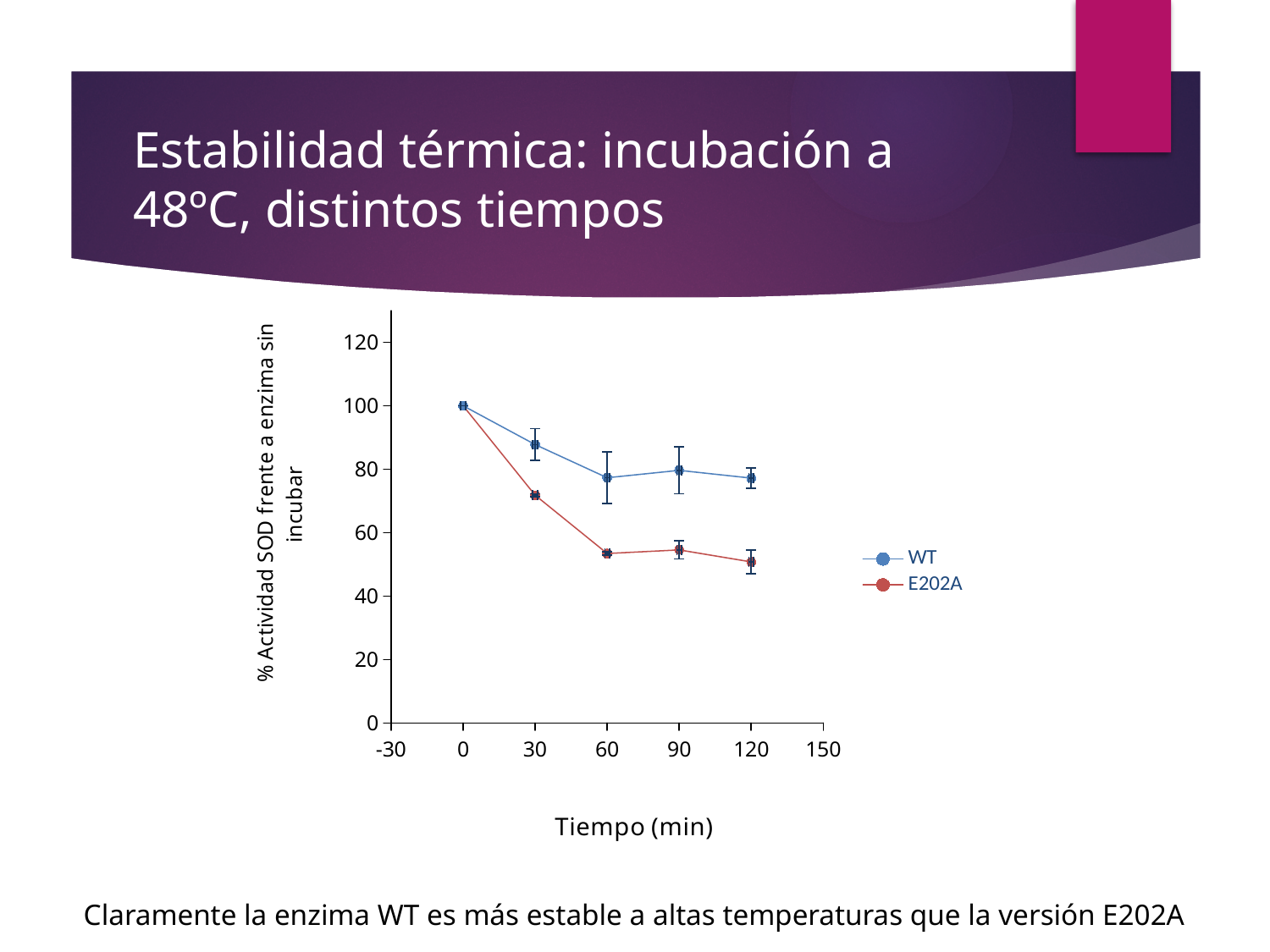
What kind of chart is shown on the slide? line chart Is the value for WT at 120 min greater or less than 60? greater How many data points are plotted for the WT series? 5 How many series does the legend list? 2 What are the two series named in the legend? WT and E202A Is the value for E202A at 60 min greater or less than 60? less Is the value for WT at 30 min greater or less than 80? greater What is the value for E202A at 0 min? 100 What is the title of the x axis? Tiempo (min) Do the values for E202A rise or fall as time increases from 0 to 120 min? fall At 60 min, which series has the larger value, WT or E202A? WT What is the value for WT at 0 min? 100